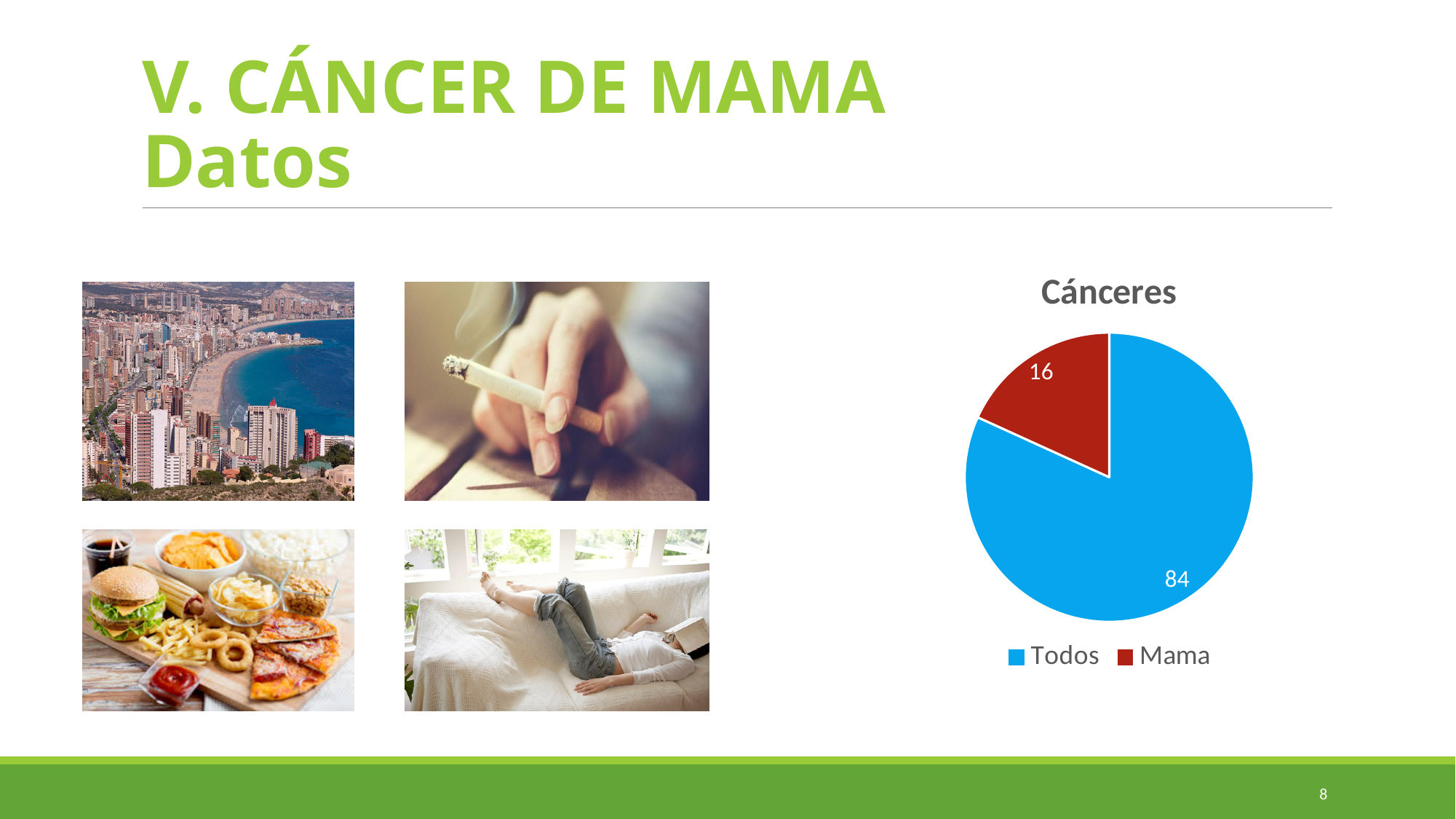
What type of chart is shown on the slide? pie chart Which slice of the pie chart is the largest? Todos How many slices does the pie chart have? 2 Which slice of the pie chart is the smallest? Mama What colour is the Mama slice in the pie chart? red What is the difference between the values for Todos and Mama? 68 What is the value for Mama in the pie chart? 16 What is the title of the chart? Cánceres Which is larger, the value for Todos or the value for Mama? Todos How many entries does the legend list? 2 What is the value for Todos in the pie chart? 84